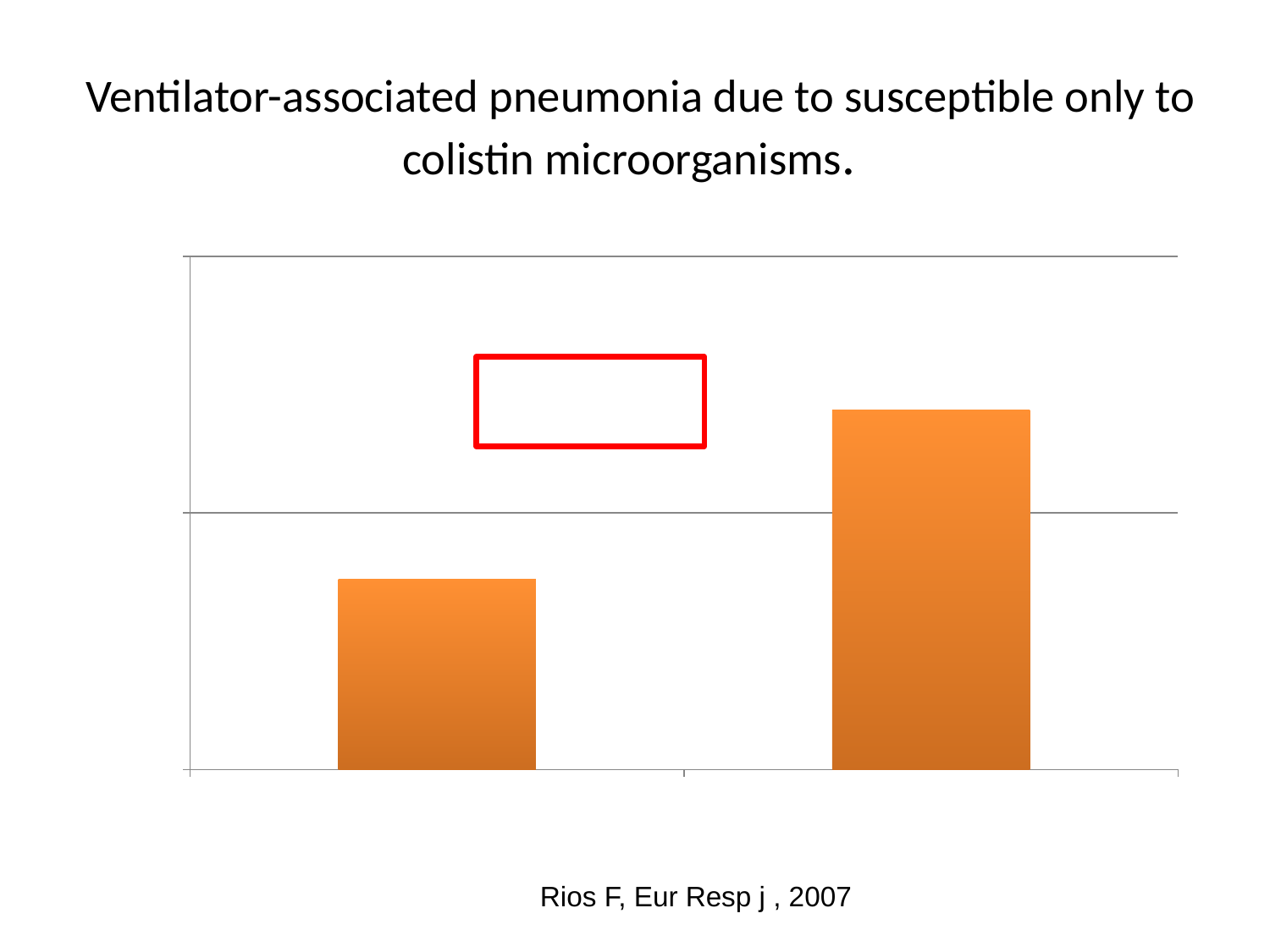
What colour are the bars in the chart? orange Which bar is the tallest in the chart? the right bar Which bar is taller, the left bar or the right bar? the right bar What is the title shown above the chart? Ventilator-associated pneumonia due to susceptible only to colistin microorganisms. Do the bar heights rise or fall from left to right? rise Which bar is the shortest in the chart? the left bar What kind of chart is shown on the slide? bar chart How many bars are plotted in the chart? 2